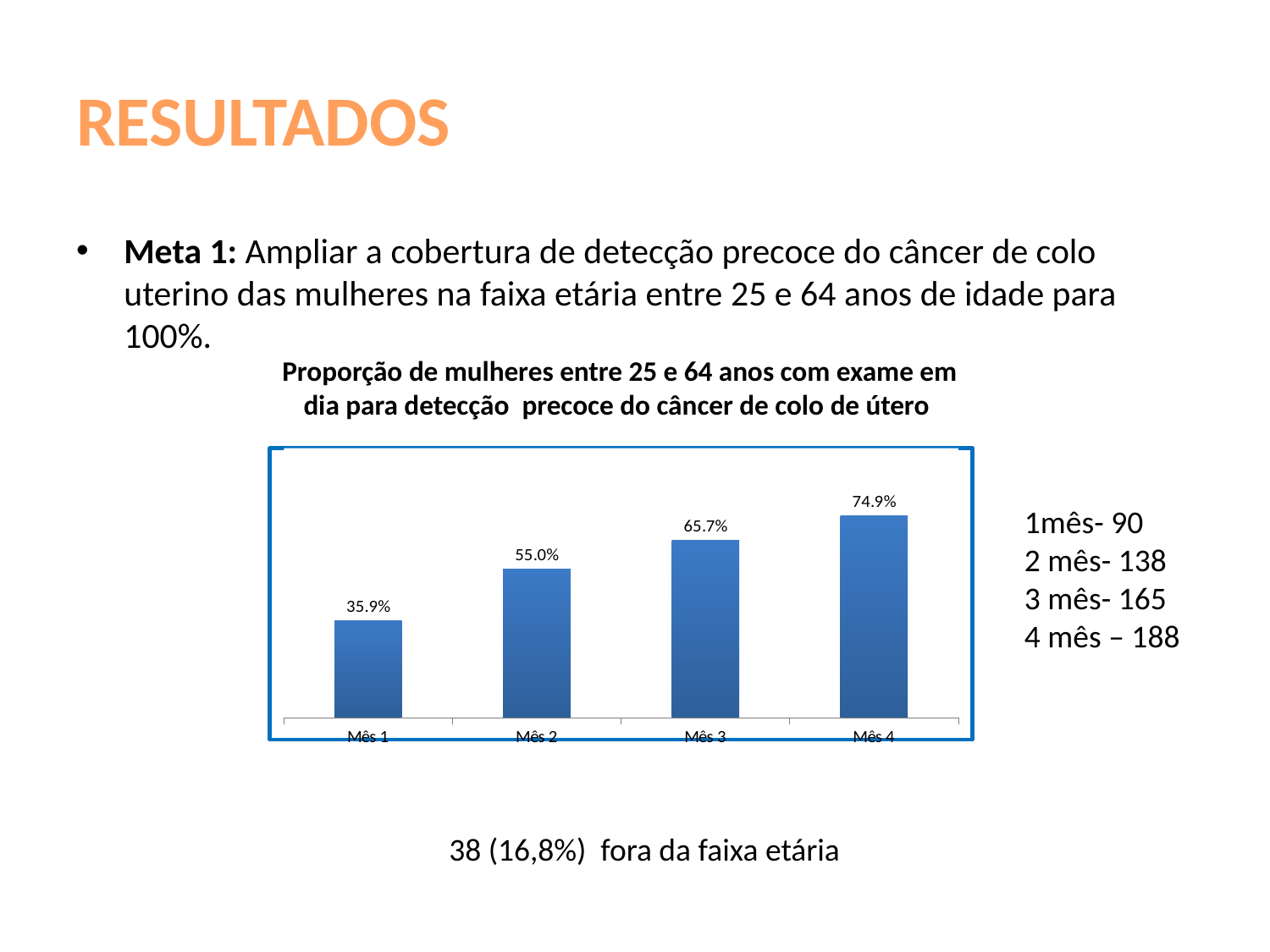
Do the values rise or fall from Mês 1 to Mês 4? Rise Which is larger, the value for Mês 3 or the value for Mês 2? Mês 3 Which month has the lowest value? Mês 1 What is the value for Mês 4? 74.9% What is the value for Mês 1? 35.9% What is the difference between the values for Mês 2 and Mês 1? 19.1% How many months are shown on the x axis? 4 What is the difference between the values for Mês 4 and Mês 1? 39.0% What is the value for Mês 2? 55.0% What kind of chart is this? Bar chart Which month has the highest value? Mês 4 What is the value for Mês 3? 65.7%